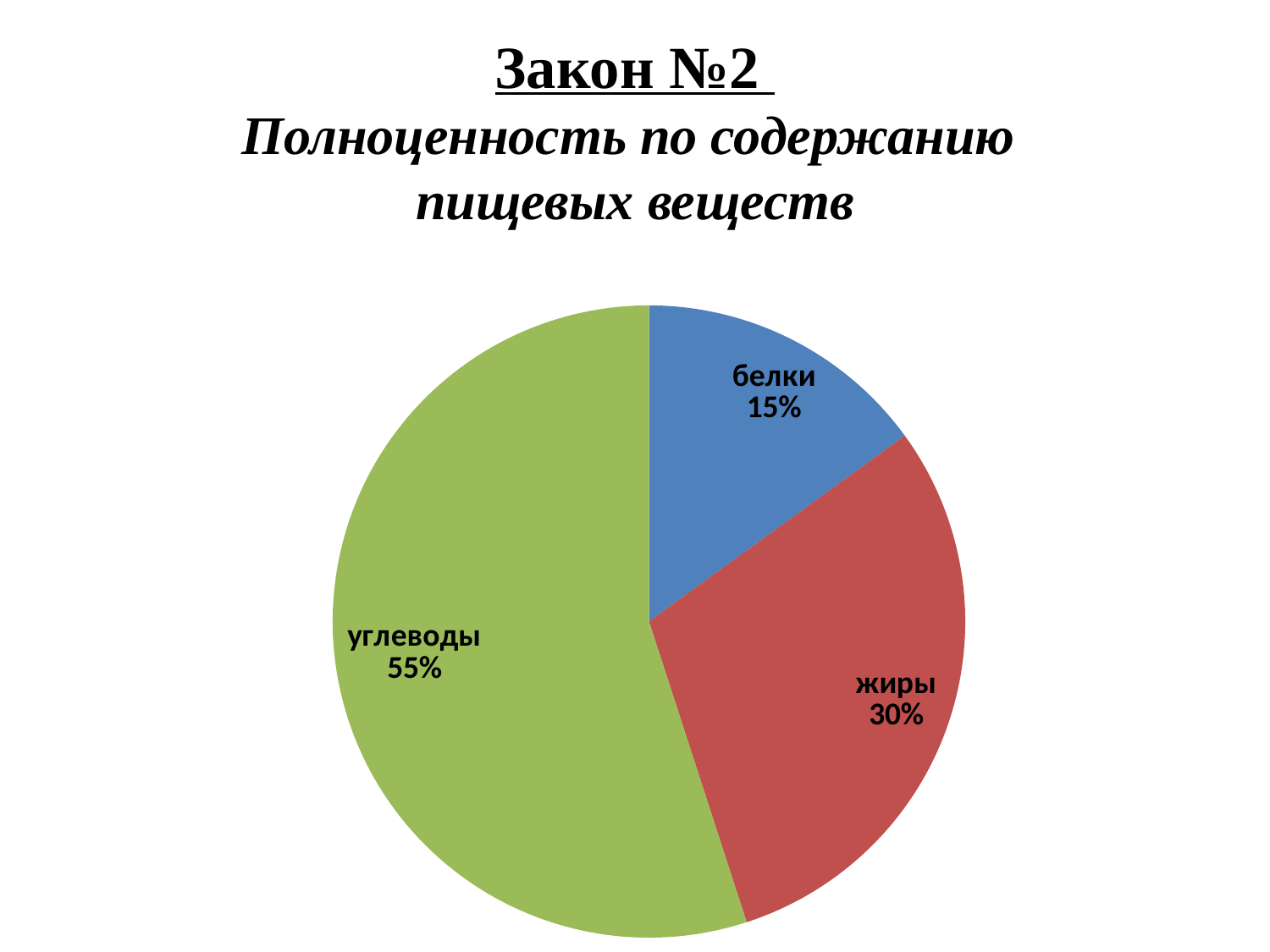
What is the difference in percentage points between жиры and белки? 15 How many slices does the pie chart have? 3 Which slice of the pie is the smallest? белки What share of the pie does углеводы have? 55% What is the difference in percentage points between углеводы and жиры? 25 What colour is the белки slice? blue What share of the pie does белки have? 15% What colour is the углеводы slice? green Which slice of the pie is the largest? углеводы Which is larger, the share for жиры or the share for белки? жиры What kind of chart is shown on the slide? pie chart What share of the pie does жиры have? 30%